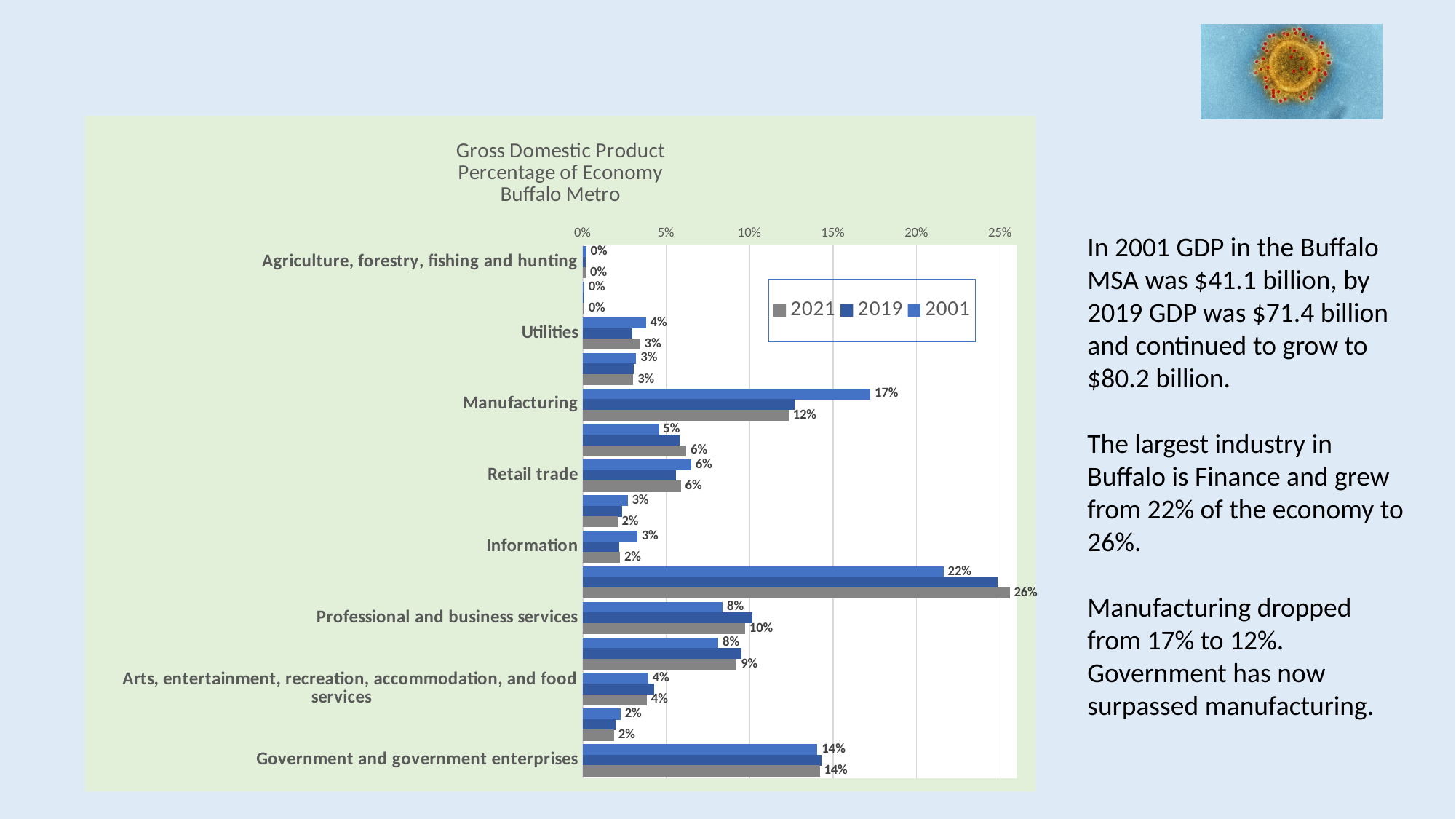
What was the 2021 value for Professional and business services? 10% What kind of chart is shown on the slide? Bar chart What was Manufacturing's percentage of the economy in 2001? 17% Is the 2019 value for Manufacturing greater or less than 10%? greater In 2001, which had the larger share of the economy: Manufacturing or Government and government enterprises? Manufacturing By how many percentage points did Manufacturing's share fall from 2001 to 2021? 5 percentage points What was Manufacturing's percentage of the economy in 2021? 12% How many series does the chart legend list? 3 What was the 2001 value for Utilities? 4% Which years are listed in the chart legend? 2021, 2019 and 2001 What was the 2021 value for Government and government enterprises? 14% Did the share for Professional and business services rise or fall from 2001 to 2021? Rise